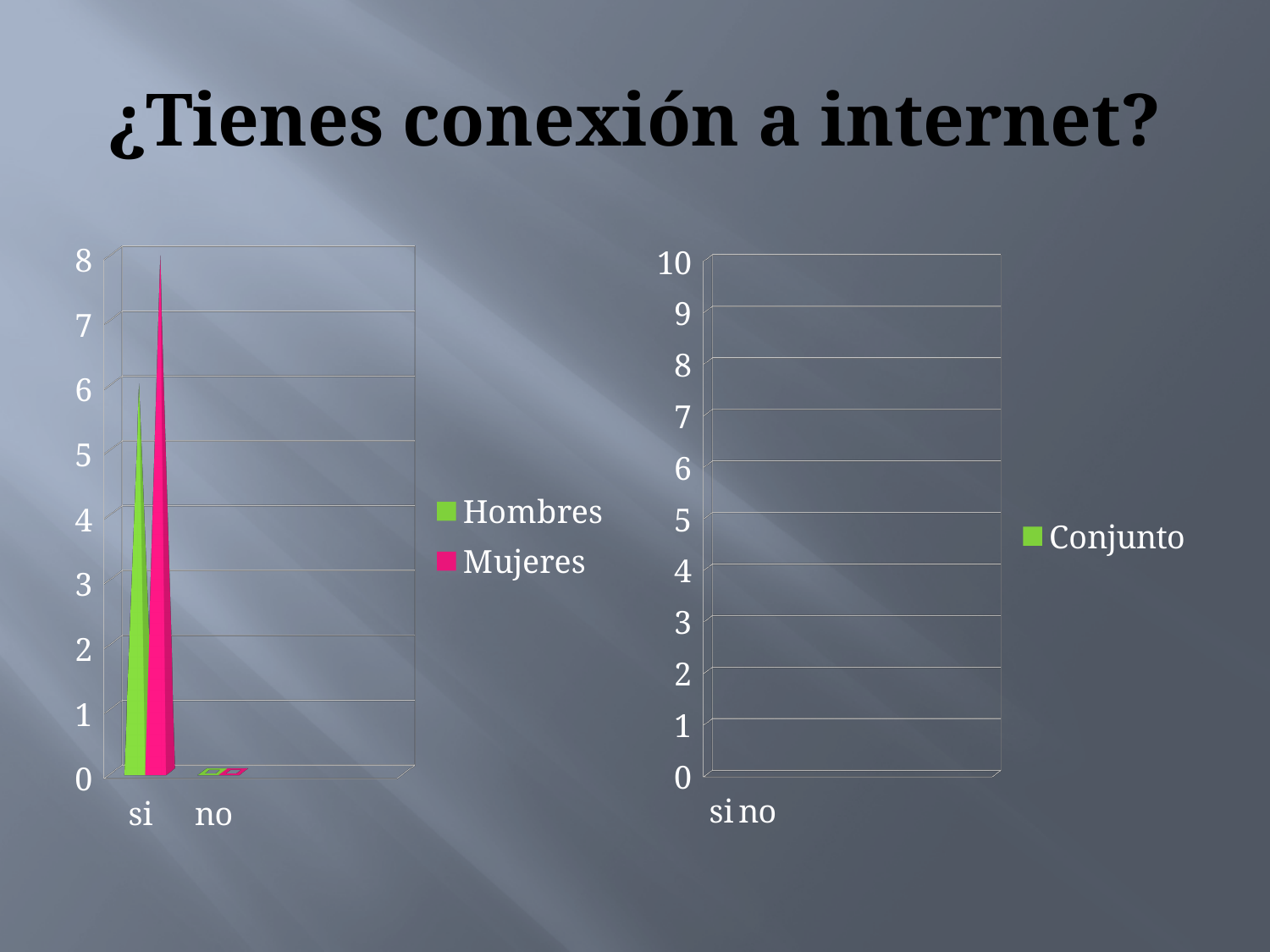
What is the highest value shown on the vertical axis of the right chart? 10 In the left chart, which category has the highest value for Hombres? si In the left chart, which series has the taller bar for "si", Hombres or Mujeres? Mujeres What is the only series listed in the legend of the right chart? Conjunto In the left chart, is the Mujeres value for "si" greater or less than 7? greater In the left chart, is the Hombres value for "si" greater or less than 5? greater How many series does the legend of the left chart list? 2 In the left chart, is the Hombres value for "si" greater or less than 7? less What kind of chart is the left chart? bar chart How many categories are shown on the x axis of the left chart? 2 In the left chart, which category has the lowest value for Mujeres? no